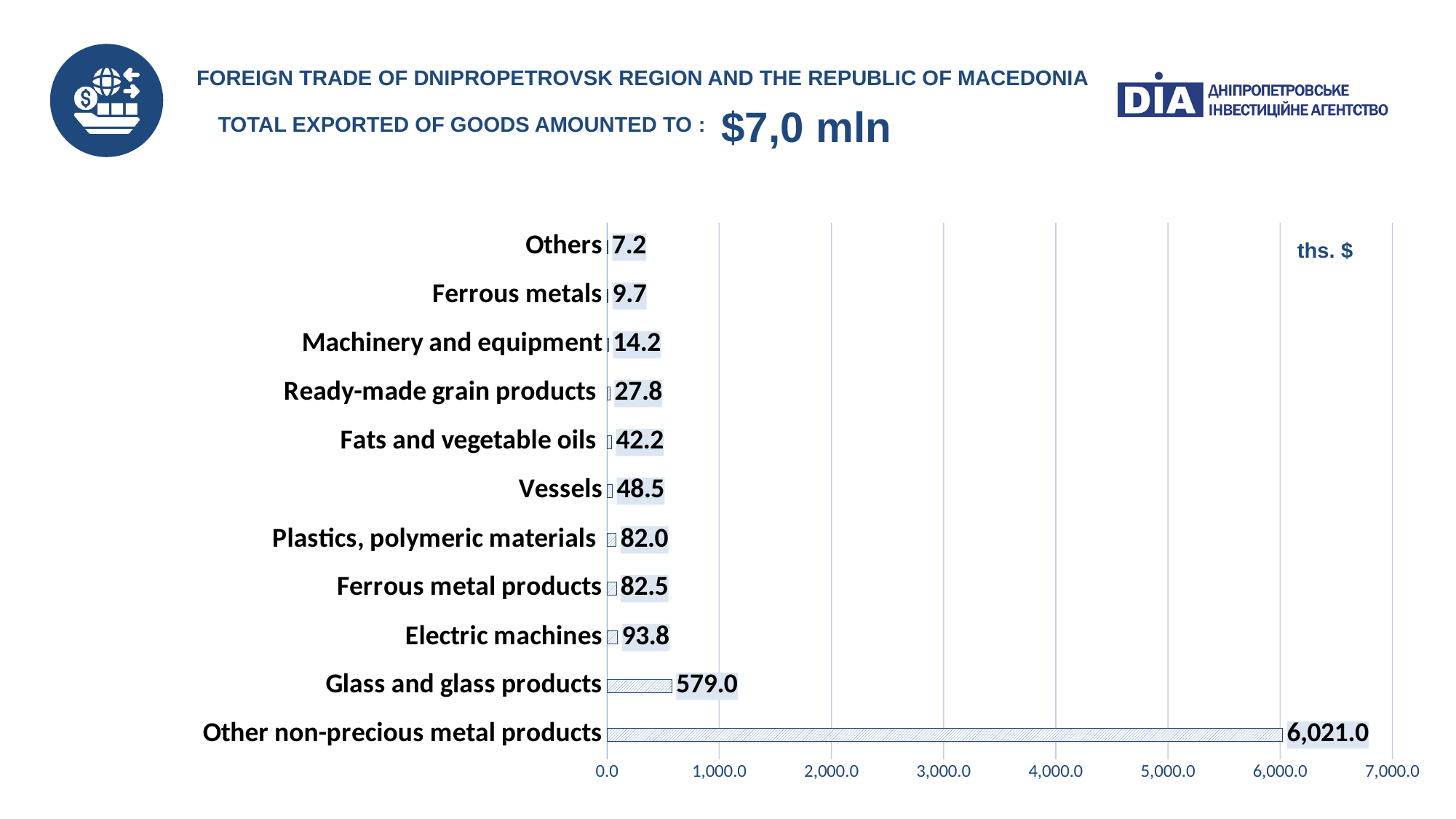
What is the value for Vessels? 48.5 Which category has the lowest value? Others Which category has the highest value? Other non-precious metal products What kind of chart is shown on the slide? Bar chart What is the value for Electric machines? 93.8 What is the value for Others? 7.2 What is the value for Glass and glass products? 579.0 What unit is indicated for the values in the chart? ths. $ What is the value for Other non-precious metal products? 6,021.0 How many categories are shown in the chart? 11 What is the difference between Other non-precious metal products and Glass and glass products? 5,442.0 Which is larger, Fats and vegetable oils or Ready-made grain products? Fats and vegetable oils